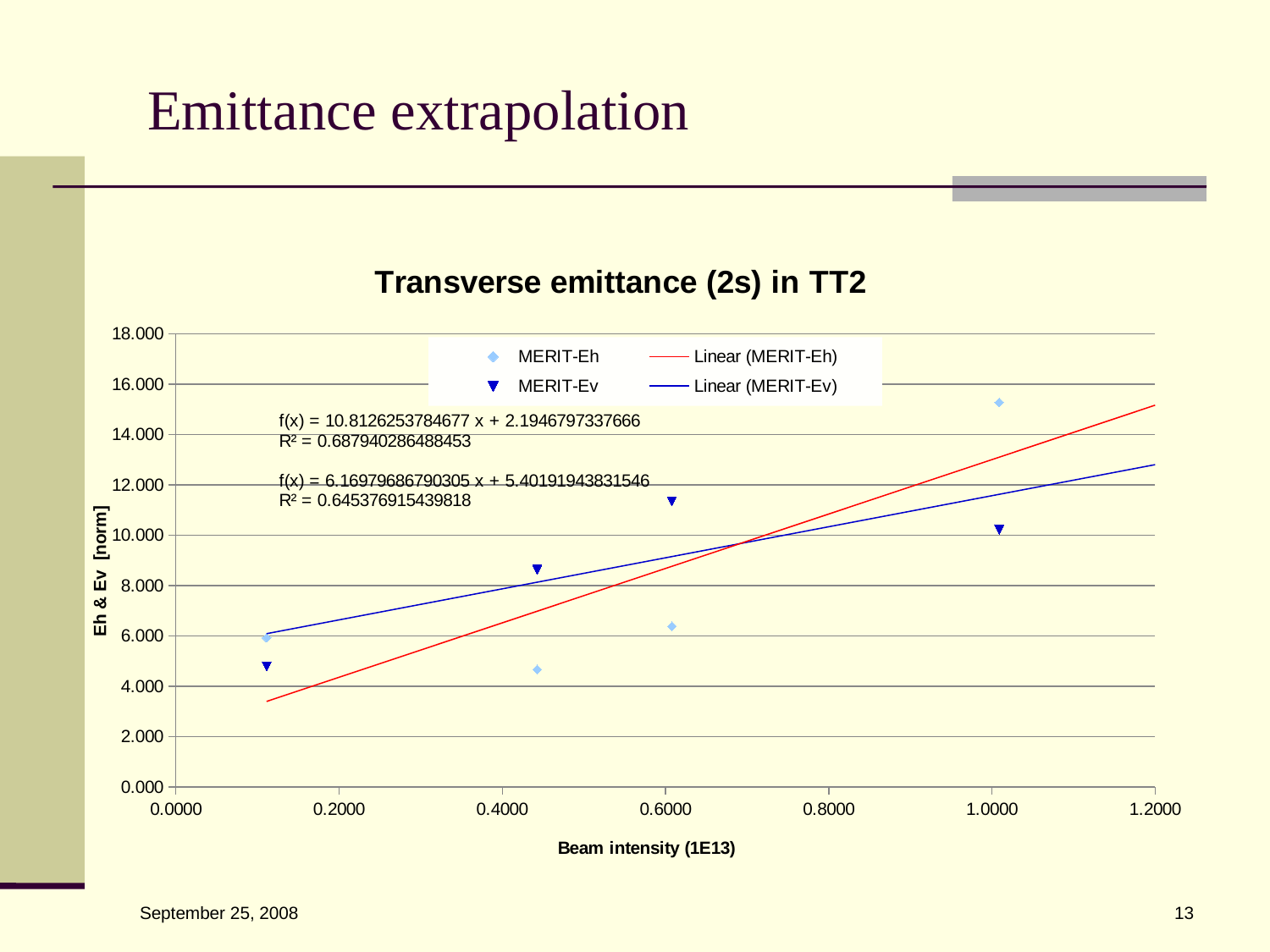
What is the R² value printed for the first fitted line, f(x) = 10.8126253784677 x + 2.1946797337666? 0.687940286488453 At a beam intensity of about 0.6, which series has the larger value, MERIT-Eh or MERIT-Ev? MERIT-Ev How many entries does the chart legend list? 4 How many MERIT-Eh data points are plotted on the chart? 4 How many MERIT-Ev data points are plotted on the chart? 4 Is the MERIT-Eh value at the highest beam intensity (about 1.0) greater or less than 14.000? greater At a beam intensity of about 1.0, which series has the larger value, MERIT-Eh or MERIT-Ev? MERIT-Eh Is the MERIT-Ev value at a beam intensity of about 0.6 greater or less than 10.000? greater Is the MERIT-Eh value at a beam intensity of about 0.4 greater or less than 6.000? less Which MERIT-Eh point has the highest value? The point at a beam intensity of about 1.0 What is the title of the chart? Transverse emittance (2s) in TT2 What kind of chart is shown on the slide? Scatter chart